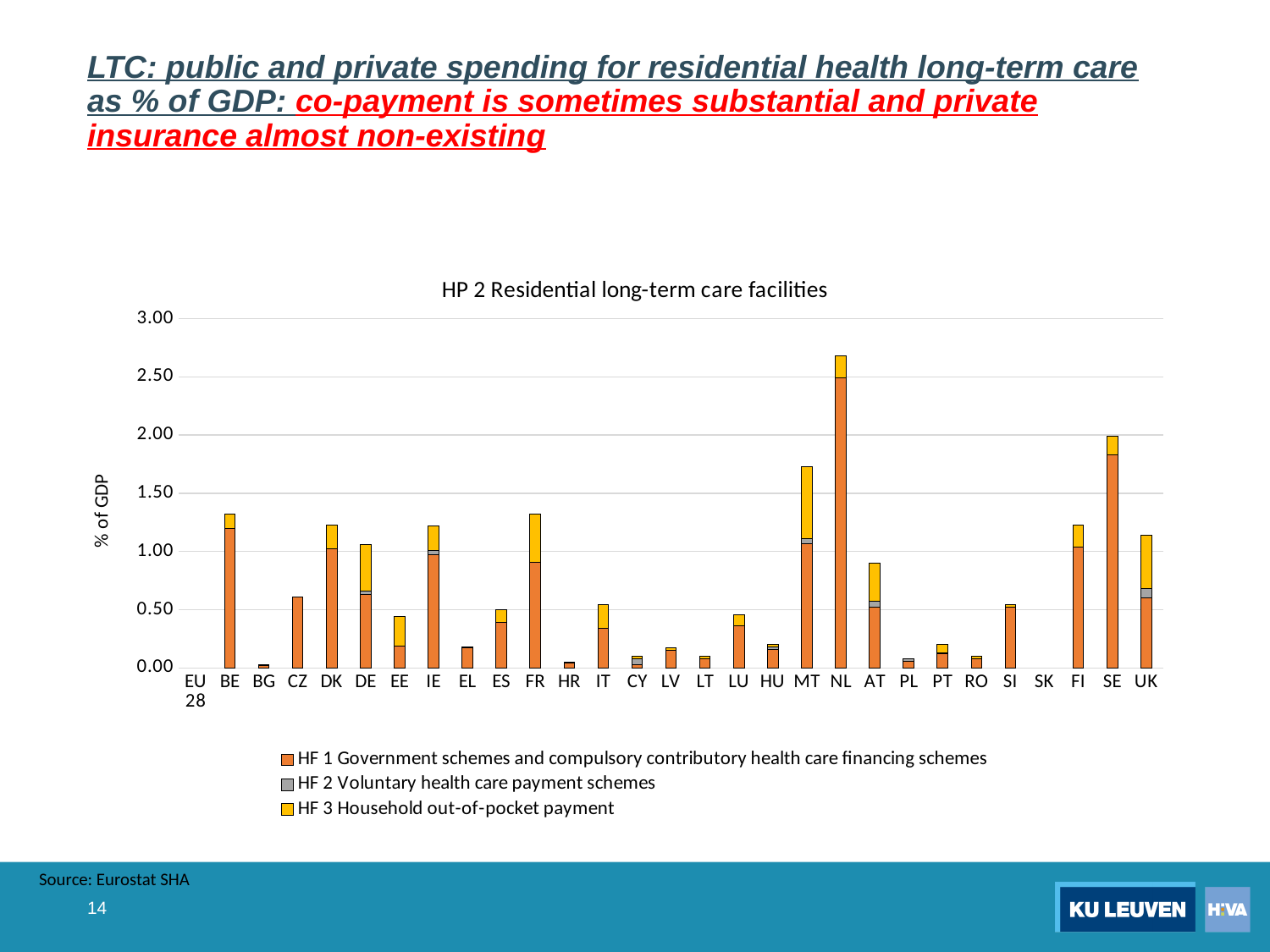
Is the total value for SE greater or less than 1.50? greater Is the total value for MT greater or less than 1.50? greater What is the title of the chart? HP 2 Residential long-term care facilities What type of chart is shown on the slide? Stacked bar chart Which has the larger total bar, MT or BE? MT Which country has the highest total bar in the chart? NL Is the total value for FR greater or less than 1.00? greater How many categories are shown on the x axis of the chart? 29 How many series does the legend list? 3 Which has the larger total bar, NL or SE? NL